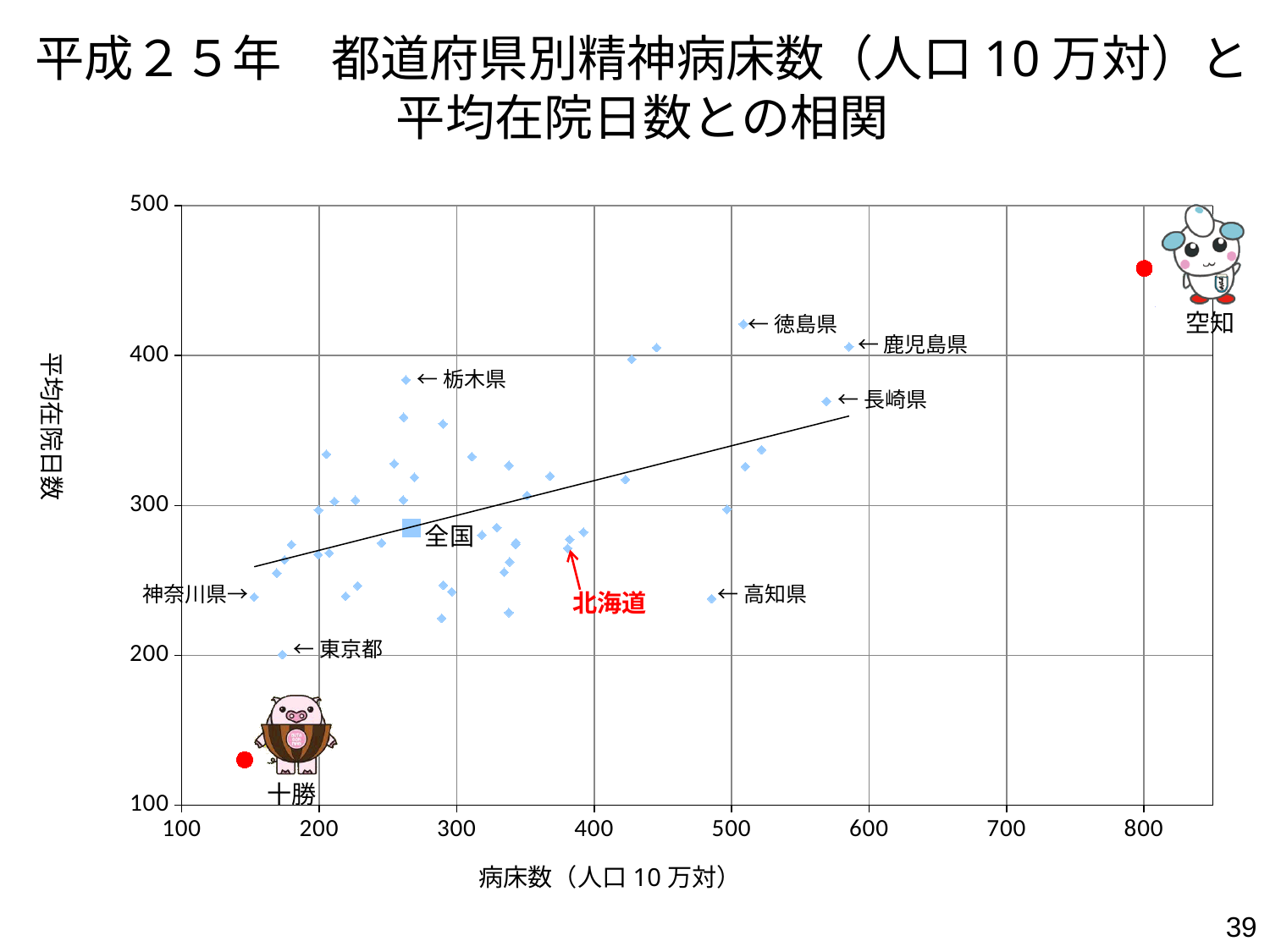
Is the 病床数 value for 長崎県 greater or less than 500? greater Which has a higher 平均在院日数, 徳島県 or 東京都? 徳島県 Is the 平均在院日数 value for 十勝 greater or less than 200? less Is the 病床数 value for 東京都 greater or less than 200? less Which labeled point has the highest 平均在院日数? 空知 Does the fitted trend line rise or fall as 病床数 increases? rises What is the label of the horizontal axis? 病床数（人口10万対） What kind of chart is shown on the slide? scatter chart Which labeled point has the lowest 平均在院日数? 十勝